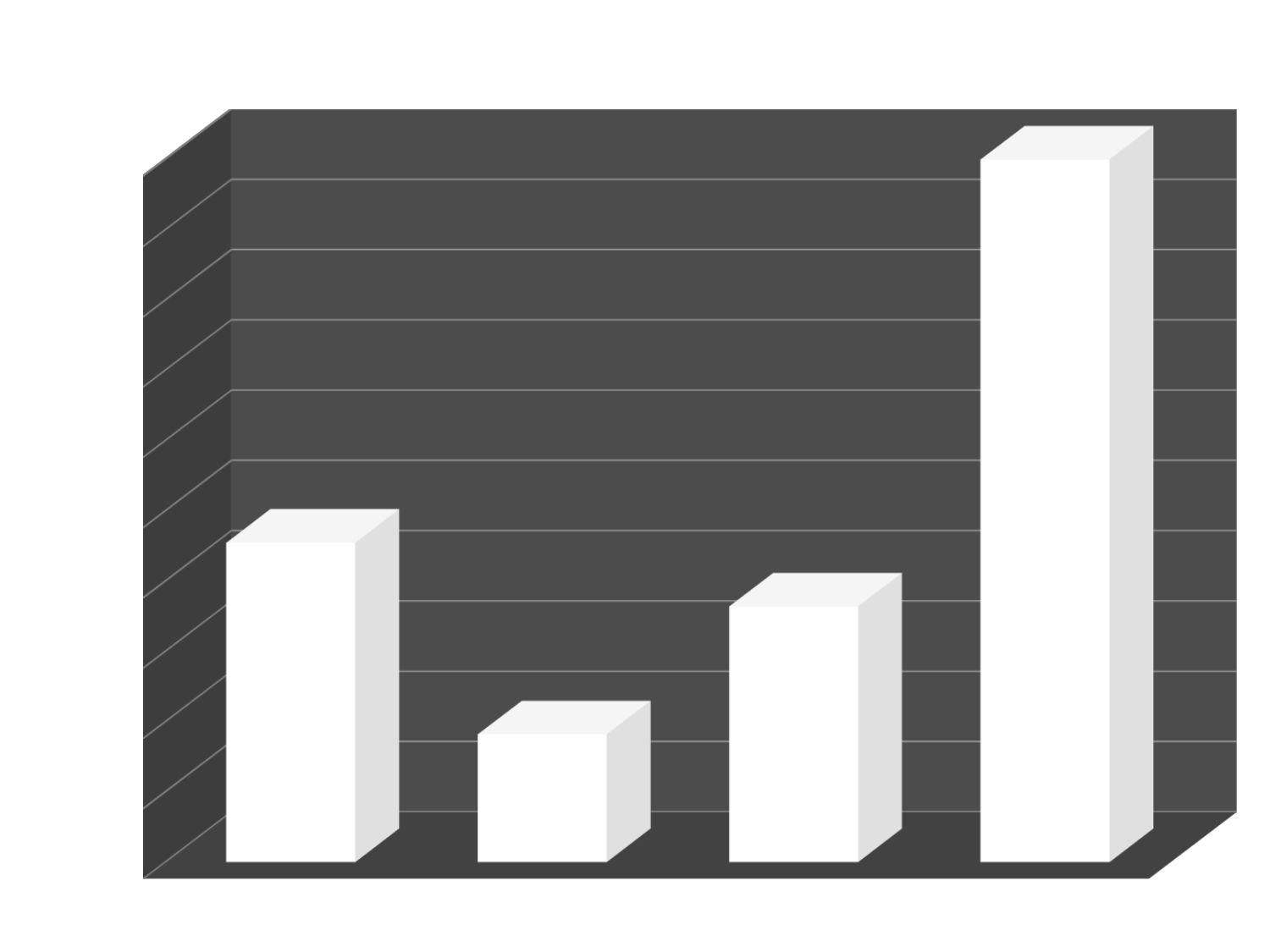
Which is taller, the third bar from the left or the second bar from the left? the third bar How many bars are plotted in the chart? 4 What colour are the bars in the chart? white Does the chart display a legend? no Which bar is the tallest in the chart, counting from the left? the fourth (rightmost) bar Do the bar heights rise steadily from left to right across the chart? no Which bar is the shortest in the chart, counting from the left? the second bar Which is taller, the first bar from the left or the third bar from the left? the first bar What kind of chart is shown on the slide? bar chart